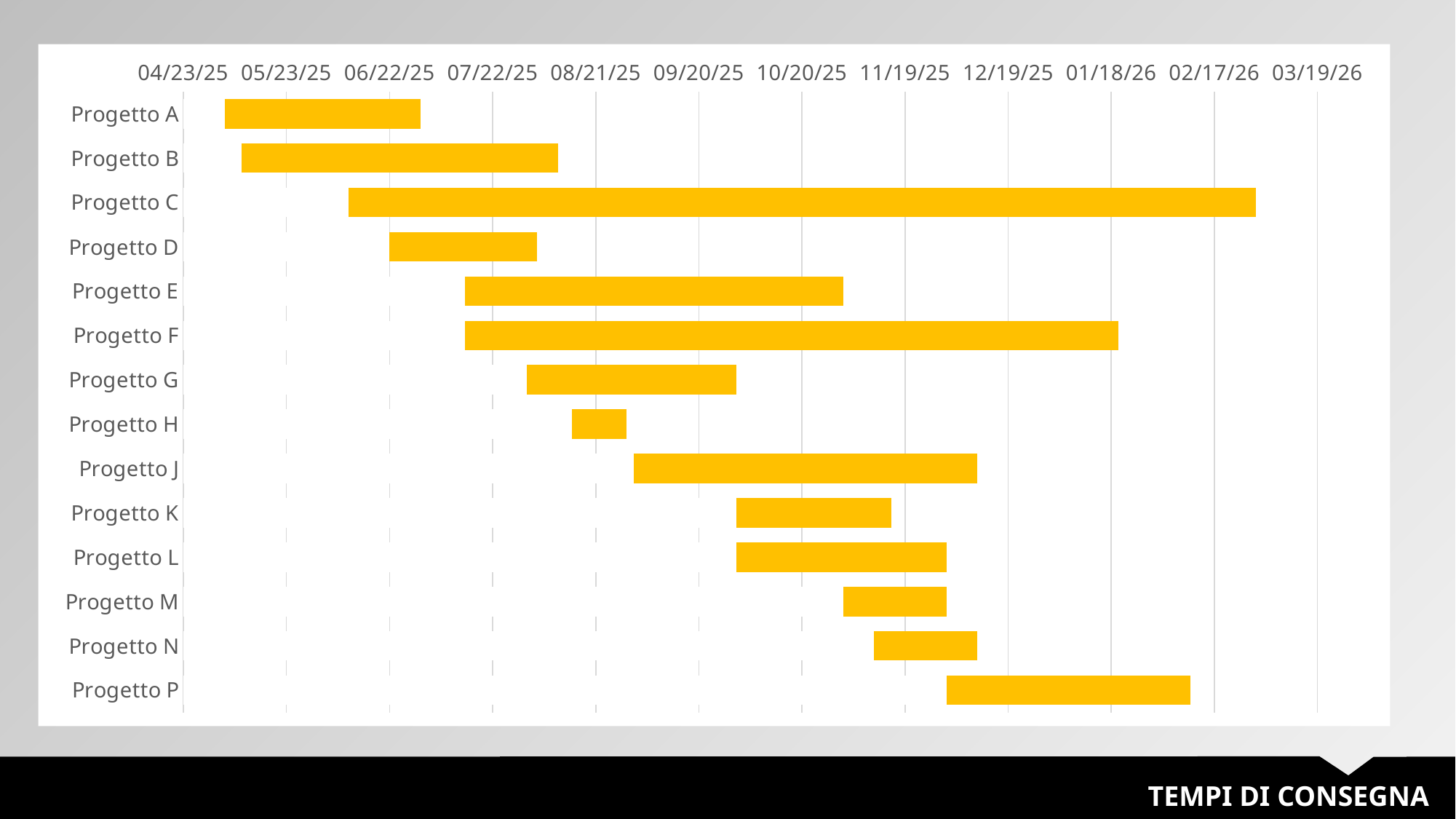
Which bar is longer, Progetto E or Progetto F? Progetto F Does the bar for Progetto E end before or after 10/20/25? after Does the bar for Progetto J start before or after 08/21/25? after Which bar is longer, Progetto A or Progetto B? Progetto B Does the bar for Progetto C end before or after 02/17/26? after What is the title shown at the bottom of the slide? TEMPI DI CONSEGNA How many projects are listed on the chart? 14 What kind of chart is shown on the slide? Bar chart (Gantt chart) Which bar is longer, Progetto G or Progetto H? Progetto G Which project has the longest bar on the chart? Progetto C Which project has the shortest bar on the chart? Progetto H